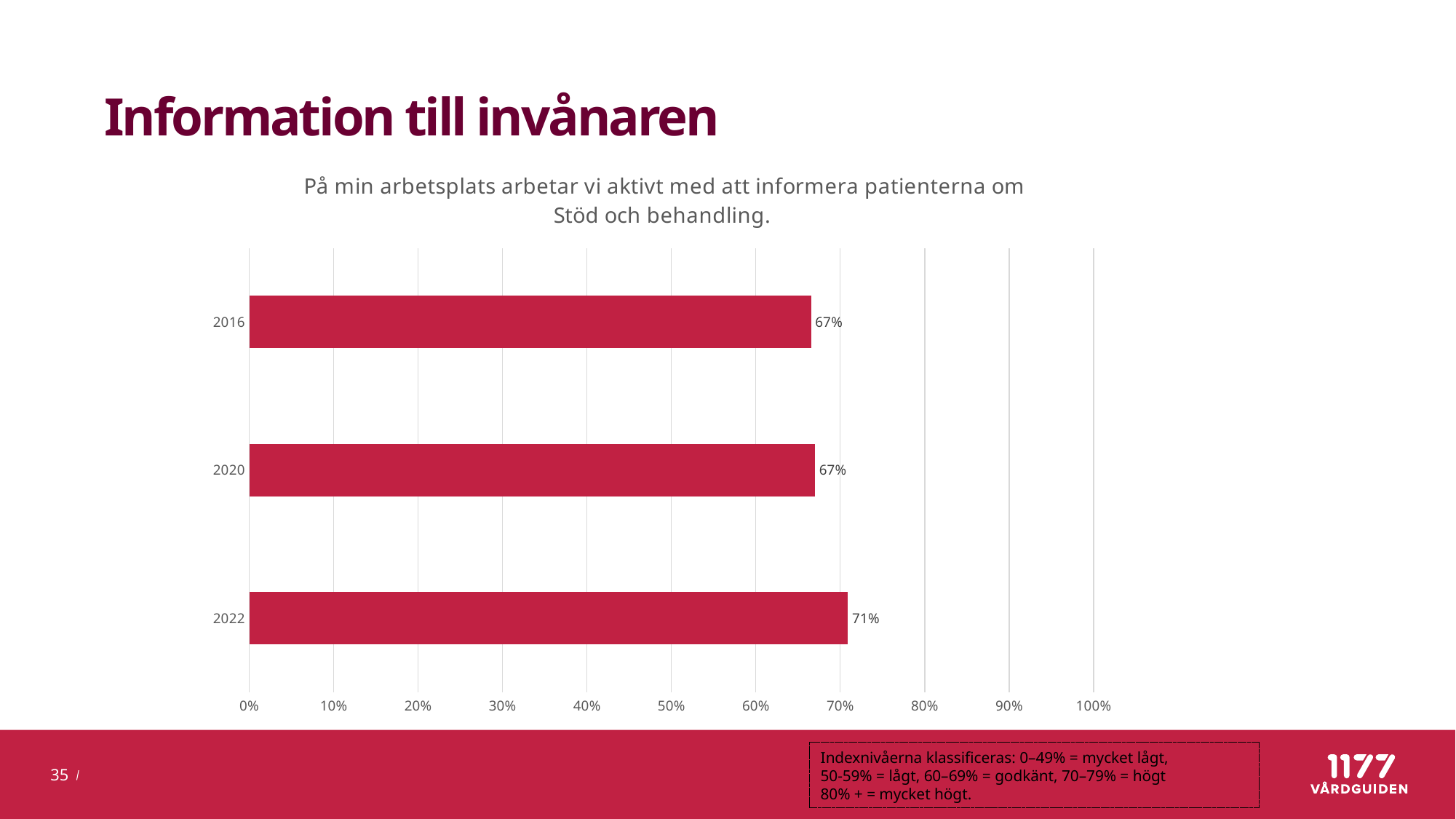
Which is larger, the value for 2022 or the value for 2016? 2022 What kind of chart is shown on the slide? bar chart What is the maximum value shown on the horizontal axis? 100% Do the values rise or fall from 2016 to 2022? rise Which year has the highest value? 2022 How many years are shown in the chart? 3 Is the value for 2022 greater or less than 70%? greater What is the value for 2020? 67% What is the value for 2022? 71% Is the value for 2016 greater or less than 60%? greater What is the difference between the values for 2022 and 2020? 4% What is the value for 2016? 67%